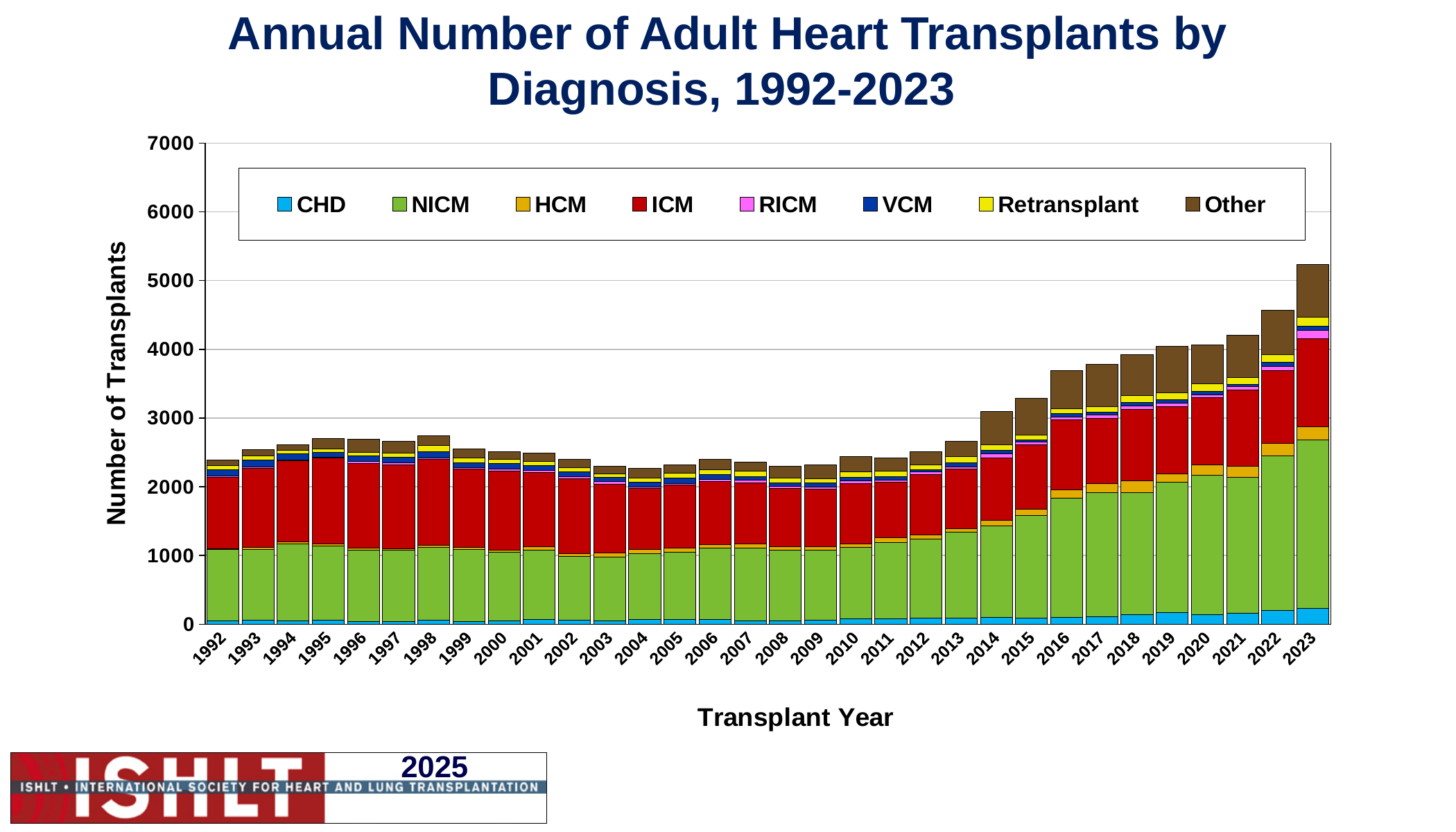
Do the total numbers of transplants rise or fall from 2014 to 2023? rise Which year has a larger total number of transplants, 2022 or 2021? 2022 What is the label of the y axis? Number of Transplants Is the total number of transplants in 1992 greater or less than 3000? less Which diagnosis is shown in red in the legend? ICM What kind of chart is shown on the slide? Stacked bar chart Is the total number of transplants in 2022 greater or less than 4000? greater Is the total number of transplants in 2004 greater or less than 2500? less How many transplant years are shown on the x axis? 32 Which year has the highest total number of transplants? 2023 How many series does the legend list? 8